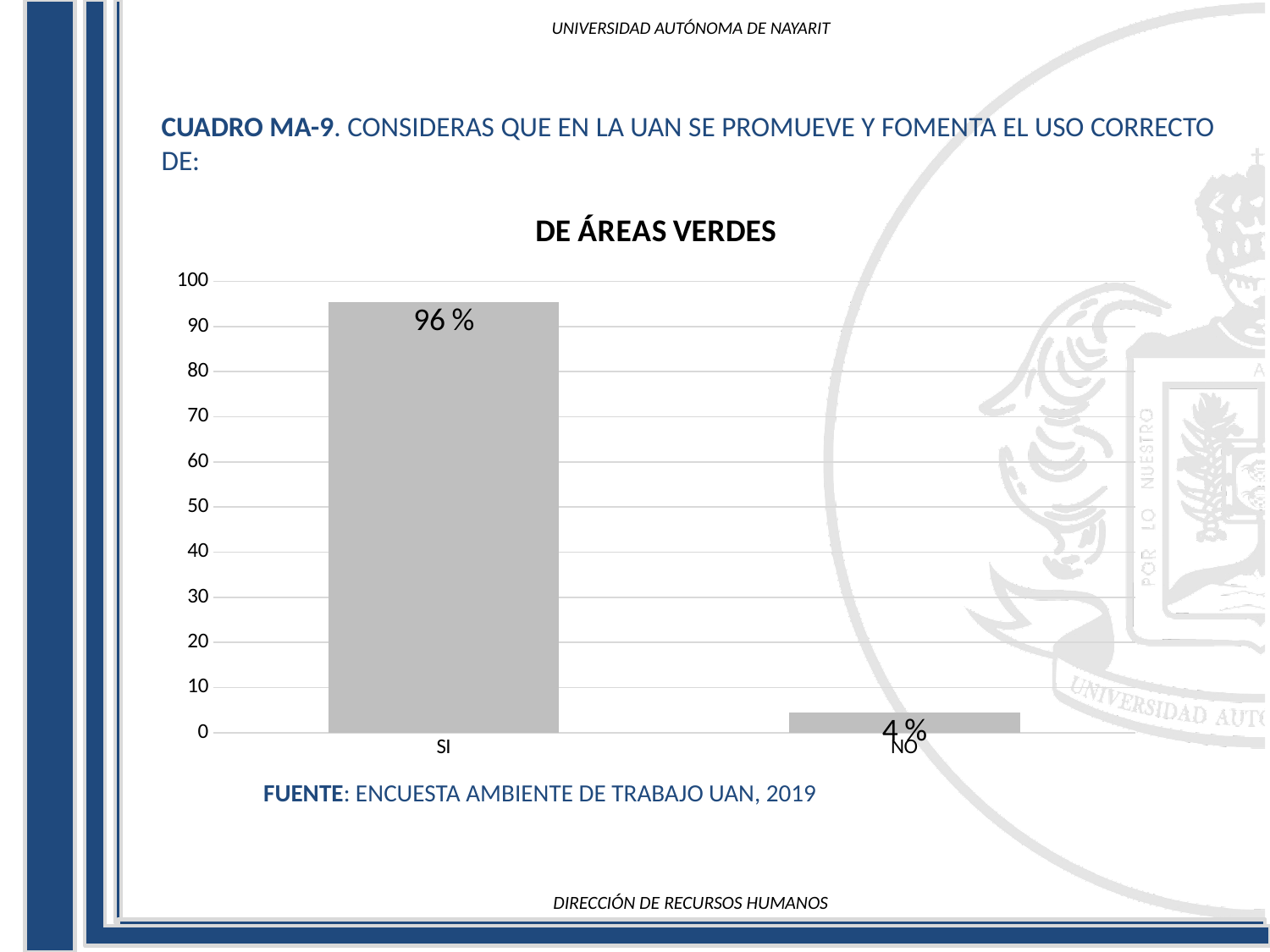
Is the value for NO greater or less than 10? less What is the title of the chart? DE ÁREAS VERDES Which category has the highest value? SI What is the source cited below the chart? ENCUESTA AMBIENTE DE TRABAJO UAN, 2019 How many categories are shown on the x axis? 2 Which category has the lowest value? NO Which is larger, the value for SI or the value for NO? SI What kind of chart is shown? bar chart What is the value for NO? 4 % What is the value for SI? 96 % What is the difference between the values for SI and NO? 92 % Is the value for SI greater or less than 90? greater